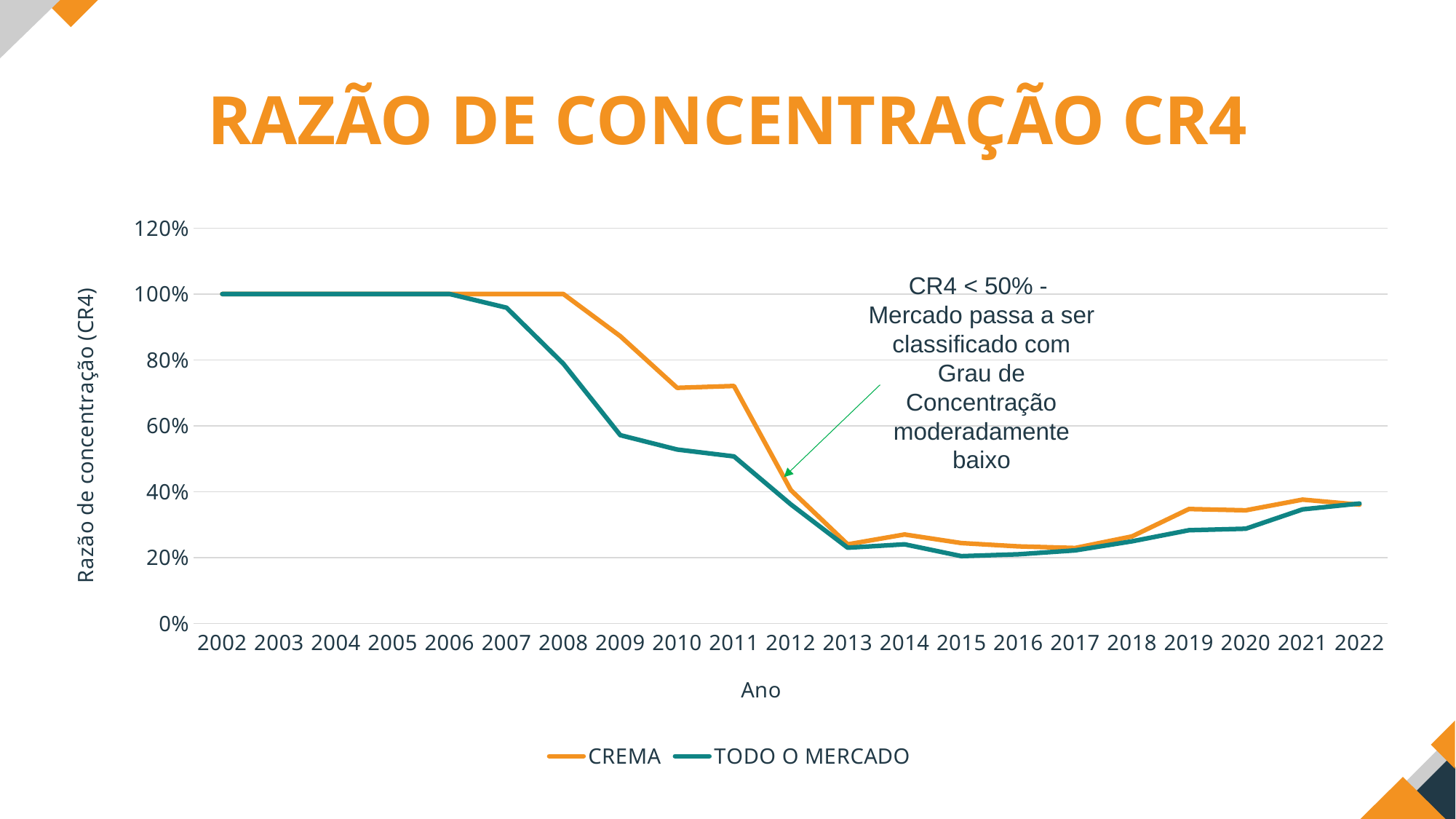
Is the value for CREMA in 2015 greater or less than 40%? less How many years are plotted along the x axis? 21 What is the value for CREMA in 2002? 100% Is the value for TODO O MERCADO in 2022 greater or less than 20%? greater Is the value for TODO O MERCADO in 2009 greater or less than 80%? less In 2011, which series has the larger value, CREMA or TODO O MERCADO? CREMA How many series does the legend list? 2 Does the CREMA line rise or fall from 2006 to 2013? fall What is the value for TODO O MERCADO in 2006? 100% What is the title of the x axis? Ano What kind of chart is shown on the slide? line chart